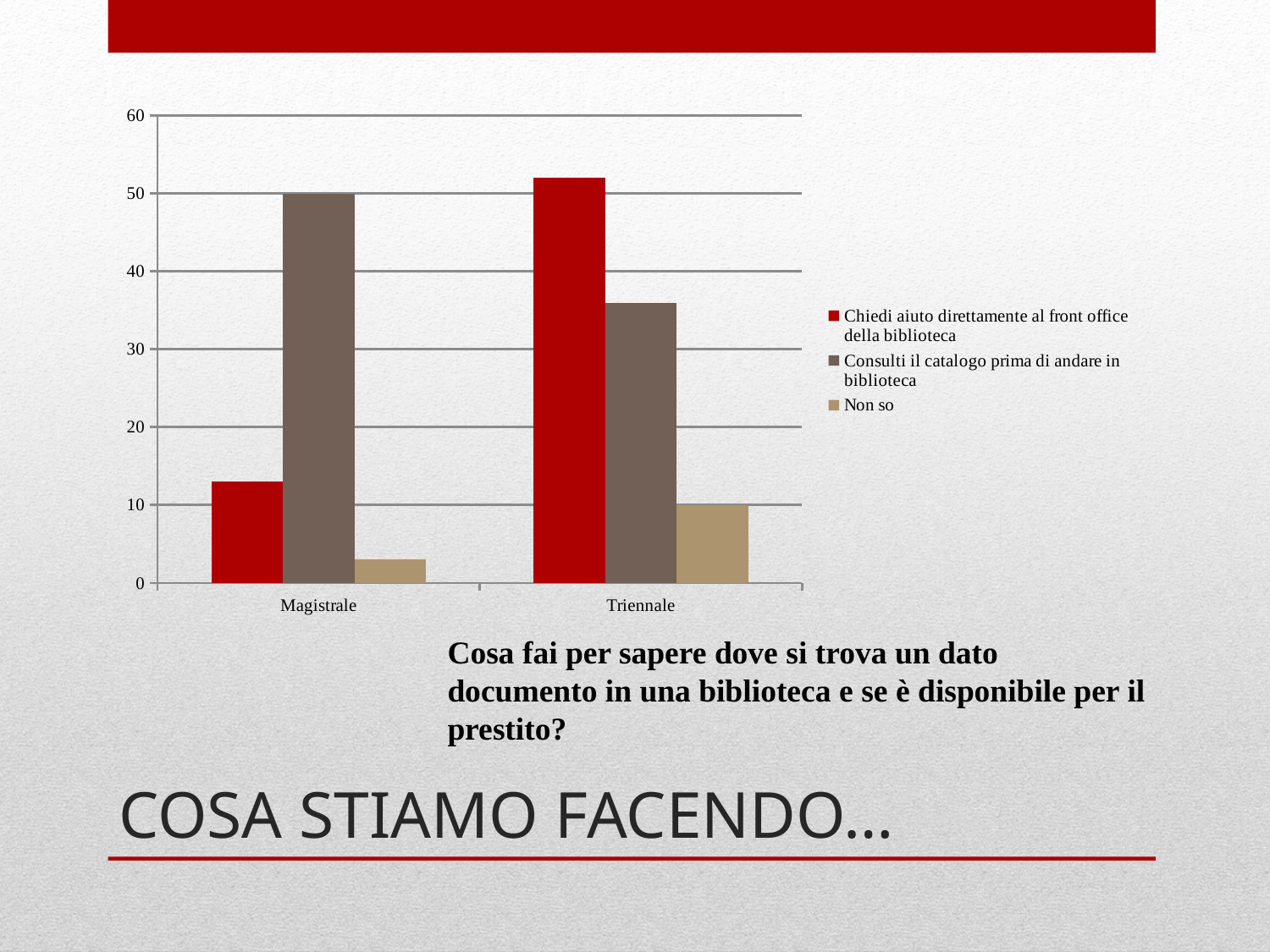
What is the value for 'Non so' for Triennale? 10 Which series has the highest value for Magistrale? Consulti il catalogo prima di andare in biblioteca What colour are the bars for the 'Non so' series? tan Is the value for 'Chiedi aiuto direttamente al front office della biblioteca' for Magistrale greater or less than 20? less How many categories are shown on the x axis? 2 Which series has the highest value for Triennale? Chiedi aiuto direttamente al front office della biblioteca What kind of chart is shown on the slide? bar chart Which series has the lowest value for Magistrale? Non so How many series does the legend list? 3 What is the value for 'Consulti il catalogo prima di andare in biblioteca' for Magistrale? 50 Which is larger: 'Consulti il catalogo prima di andare in biblioteca' for Magistrale or for Triennale? Magistrale Is the value for 'Chiedi aiuto direttamente al front office della biblioteca' for Triennale greater or less than 50? greater